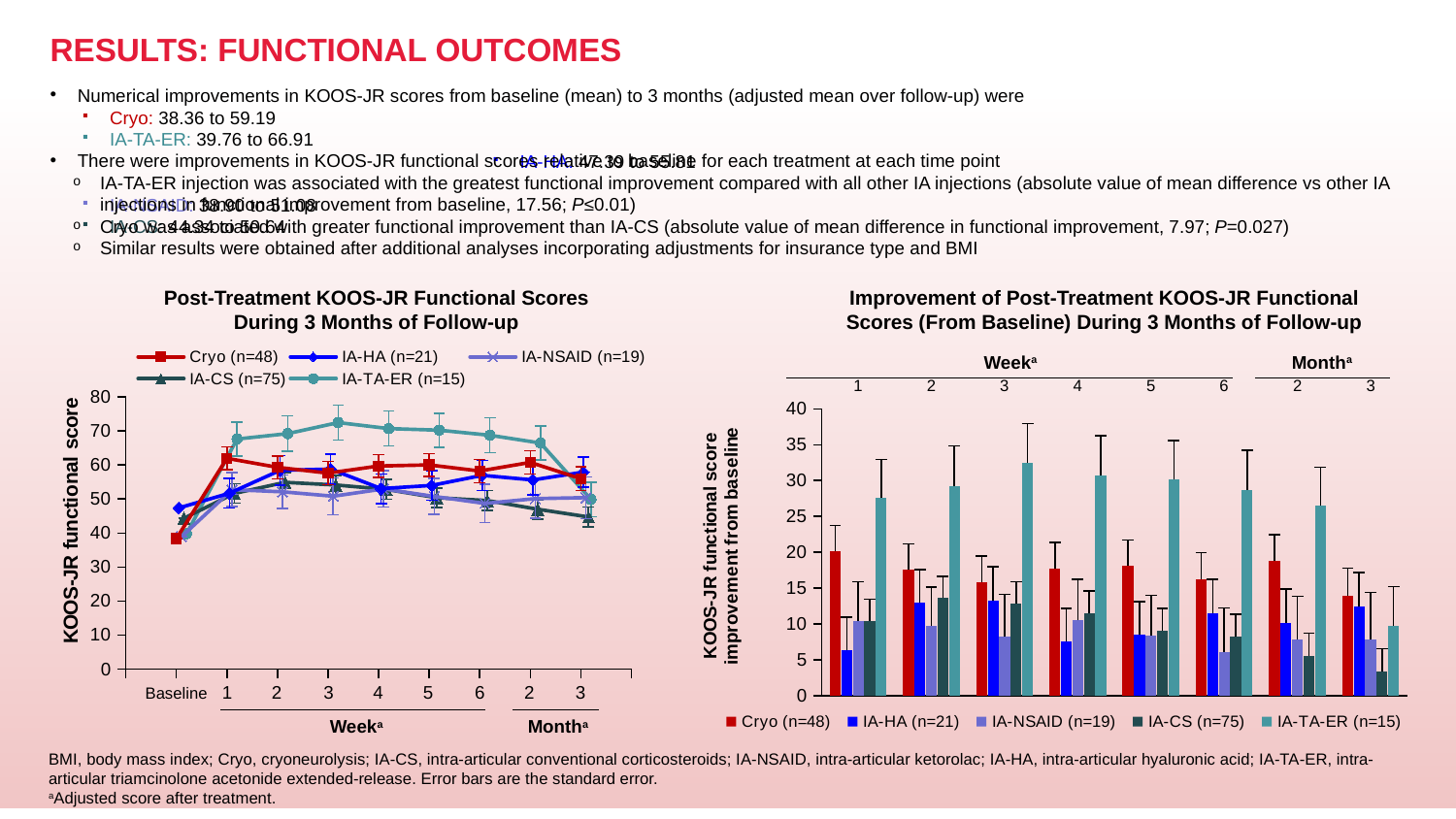
In the right bar chart, is the improvement for IA-HA at Week 1 greater or less than 10? less In the right bar chart, which treatment has the tallest bar at Week 3? IA-TA-ER (n=15) In the left line chart, how many time points are shown on the x axis, including Baseline? 9 In the right bar chart, is the improvement for IA-TA-ER at Week 3 greater or less than 30? greater In the right bar chart at Week 1, which is larger, the Cryo bar or the IA-HA bar? Cryo What kind of chart is the left chart, 'Post-Treatment KOOS-JR Functional Scores During 3 Months of Follow-up'? line chart What kind of chart is the right chart, 'Improvement of Post-Treatment KOOS-JR Functional Scores (From Baseline) During 3 Months of Follow-up'? bar chart In the left line chart, how many series does the legend list? 5 In the right bar chart, how many time-point groups are shown on the x axis? 8 In the left line chart, is the IA-TA-ER score at Week 3 greater or less than 70? greater In the right bar chart, which treatment has the shortest bar at Month 3? IA-CS (n=75) In the left line chart, does the IA-TA-ER line rise or fall from Baseline to Week 1? rise